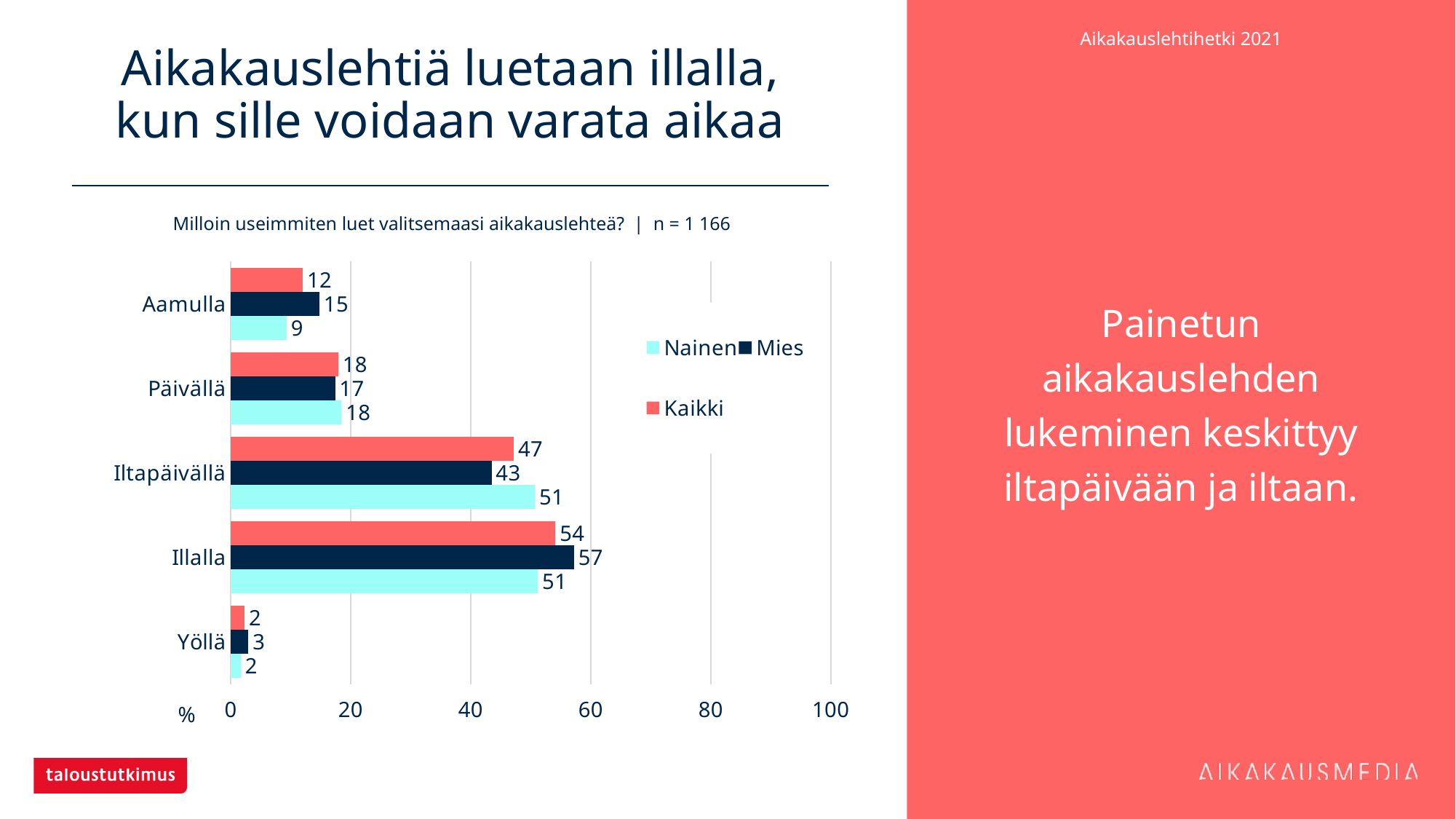
What is the sample size (n) stated above the chart? 1 166 How many categories are shown on the chart? 5 What is the value for Mies in the Illalla category? 57 Is the value for Kaikki in the Illalla category greater or less than 40? greater Which category has the lowest value for the Mies series? Yöllä What is the value for Nainen in the Iltapäivällä category? 51 Which is larger in the Aamulla category, the value for Mies or the value for Nainen? Mies How many series does the legend list? 3 What is the value for Kaikki in the Aamulla category? 12 What kind of chart is shown on the slide? bar chart Which category has the highest value for the Kaikki series? Illalla What is the difference between the Mies and Nainen values in the Iltapäivällä category? 8